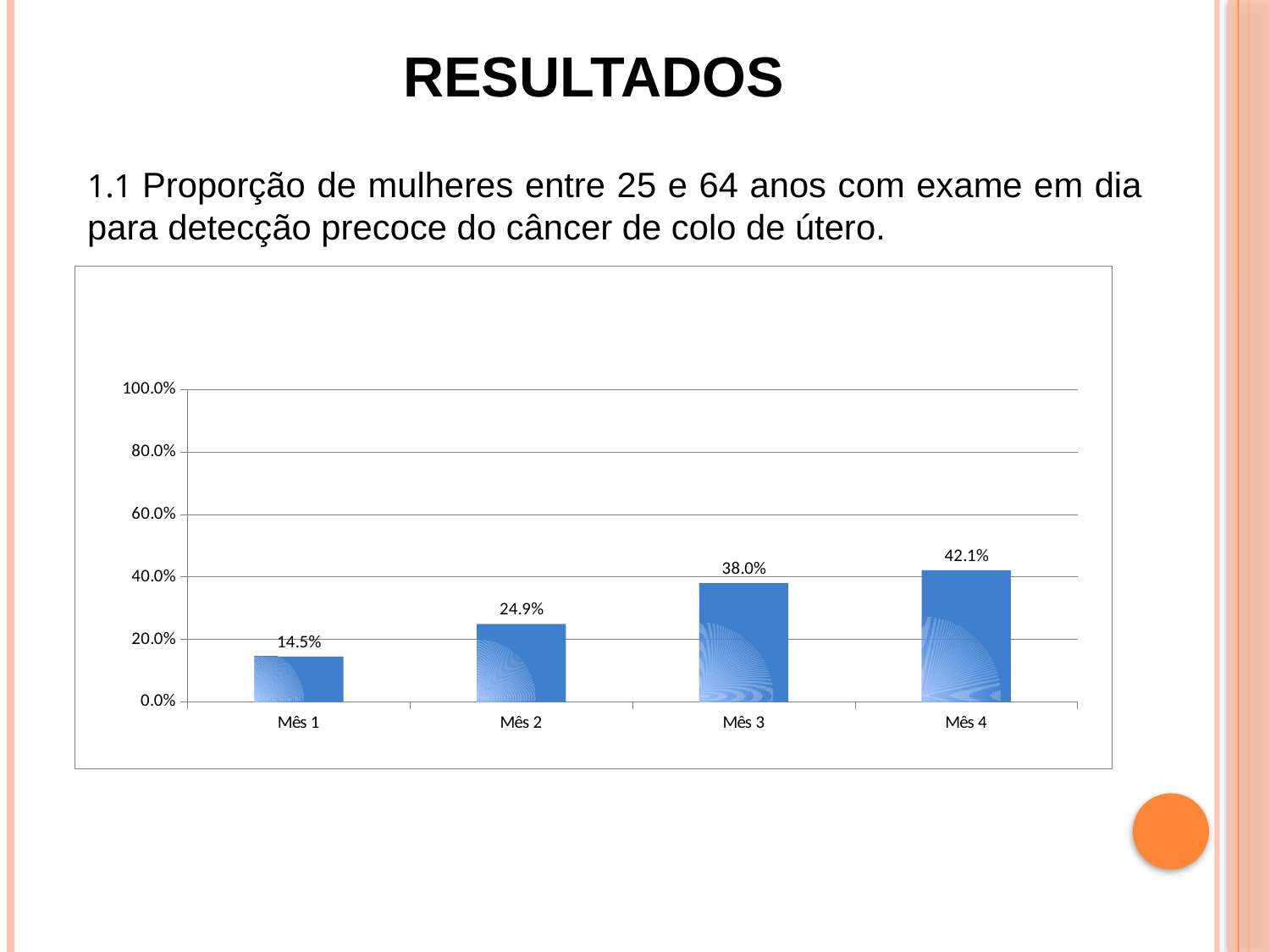
Which month has the lowest value? Mês 1 What kind of chart is shown on the slide? bar chart What is the value for Mês 4? 42.1% Which is larger, the value for Mês 2 or the value for Mês 3? Mês 3 Do the values rise or fall from Mês 1 to Mês 4? rise Which month has the highest value? Mês 4 What is the value for Mês 3? 38.0% What is the value for Mês 1? 14.5% What is the difference between the values for Mês 4 and Mês 1? 27.6% What is the difference between the values for Mês 3 and Mês 2? 13.1% Is the value for Mês 4 greater or less than 60.0%? less How many months are shown on the x axis? 4